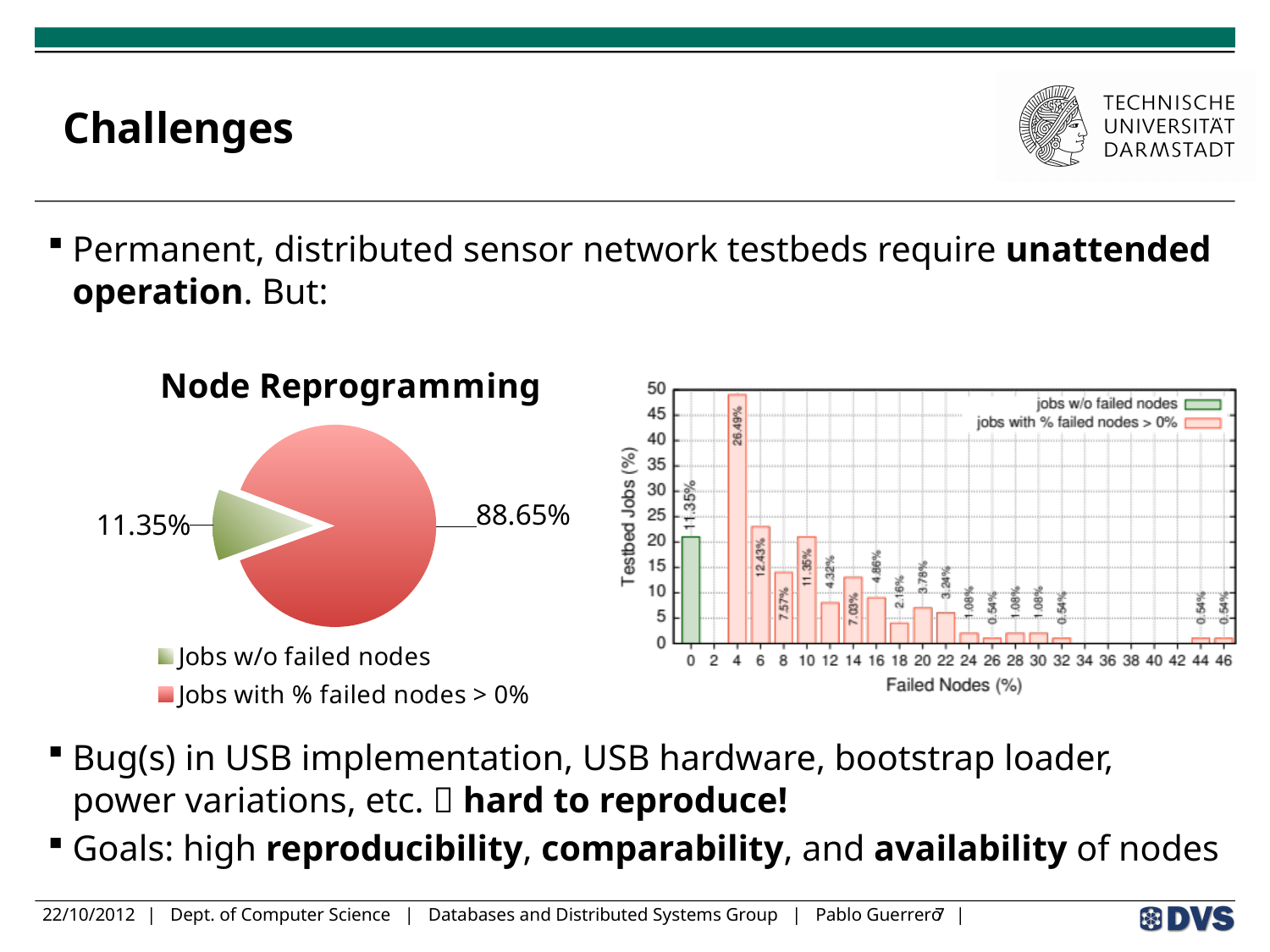
On the Node Reprogramming pie chart, what percentage is shown for Jobs with % failed nodes > 0%? 88.65% What kind of chart is the chart on the right of the slide? bar chart On the right-hand bar chart, what value is labelled on the bar at 4 on the Failed Nodes (%) axis? 26.49% On the Node Reprogramming pie chart, what percentage is shown for Jobs w/o failed nodes? 11.35% How many series does the legend of the right-hand bar chart list? 2 On the right-hand bar chart, what value is labelled on the bar at 6 on the Failed Nodes (%) axis? 12.43% On the Node Reprogramming pie chart, which slice is larger: Jobs w/o failed nodes or Jobs with % failed nodes > 0%? Jobs with % failed nodes > 0% On the right-hand bar chart, which bar is taller: the one at 6 or the one at 8 on the Failed Nodes (%) axis? 6 What kind of chart is the Node Reprogramming chart on the left? pie chart On the right-hand bar chart, at which Failed Nodes (%) value is the tallest bar? 4 How many entries does the legend of the Node Reprogramming pie chart list? 2 What is the x-axis title of the right-hand bar chart? Failed Nodes (%)